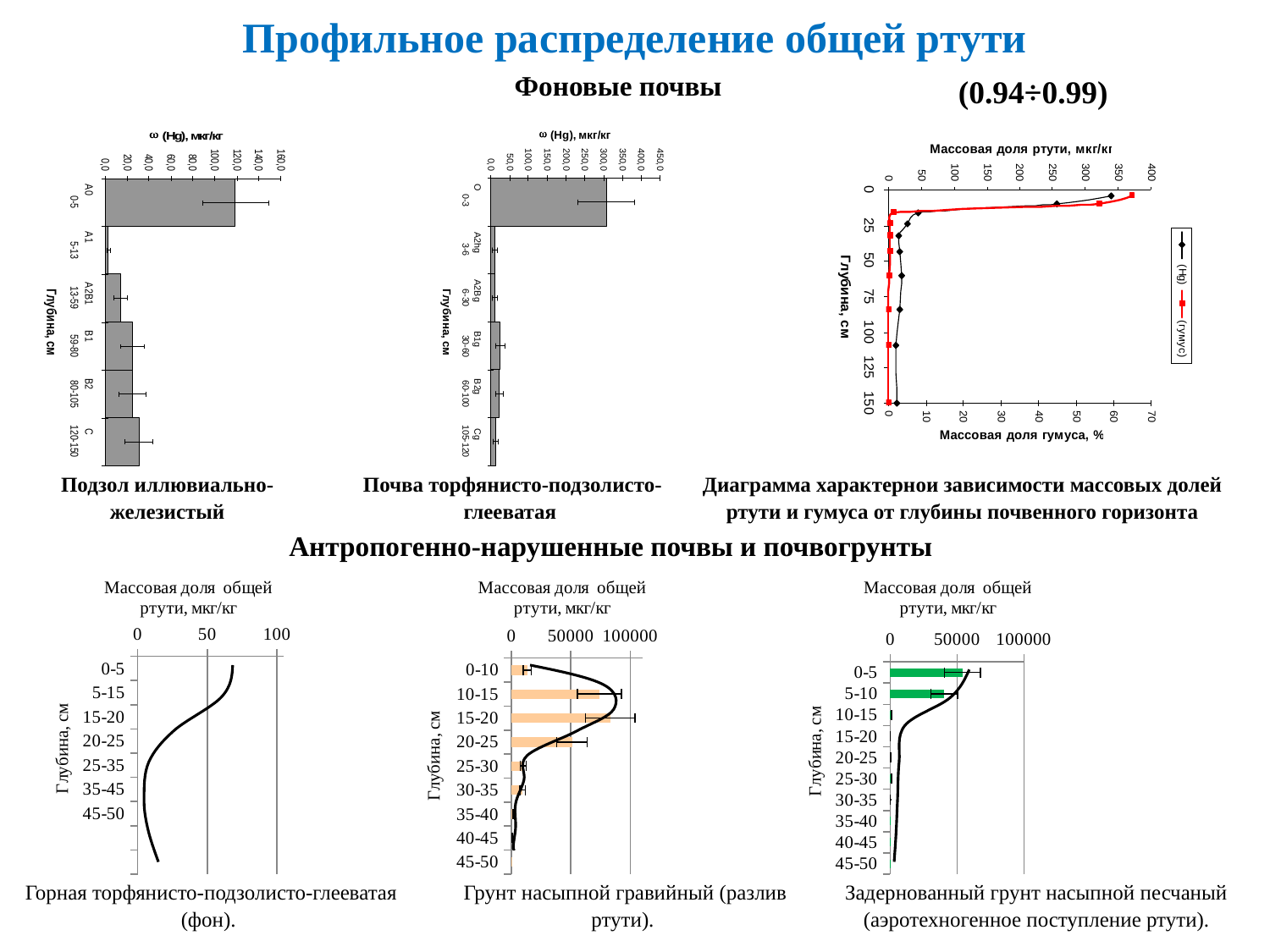
In the top-right chart, what is the label of the bottom horizontal axis? Массовая доля гумуса, % In the chart titled "Подзол иллювиально-железистый", how many horizons (categories) are plotted? 6 In the top-right chart (Диаграмма характерной зависимости массовых долей ртути и гумуса), how many series does the legend list? 2 In the chart titled "Грунт насыпной гравийный (разлив ртути)", how many depth intervals are plotted? 9 In the chart titled "Почва торфянисто-подзолисто-глееватая", is the value for horizon O (0-3) greater or less than 250? greater In the chart titled "Подзол иллювиально-железистый", is the value for horizon A0 (0-5) greater or less than 100? greater In the chart titled "Почва торфянисто-подзолисто-глееватая", which horizon has the highest mercury value? O (0-3) In the chart titled "Почва торфянисто-подзолисто-глееватая", what kind of chart is used? bar chart In the chart titled "Подзол иллювиально-железистый", which horizon has the highest mercury value? A0 (0-5) In the chart titled "Задернованный грунт насыпной песчаный", which is larger, the value for 0-5 or for 5-10? 0-5 In the chart titled "Горная торфянисто-подзолисто-глееватая (фон)", is the value for depth 0-5 greater or less than 50? greater In the chart titled "Грунт насыпной гравийный (разлив ртути)", which depth interval has the highest bar? 15-20